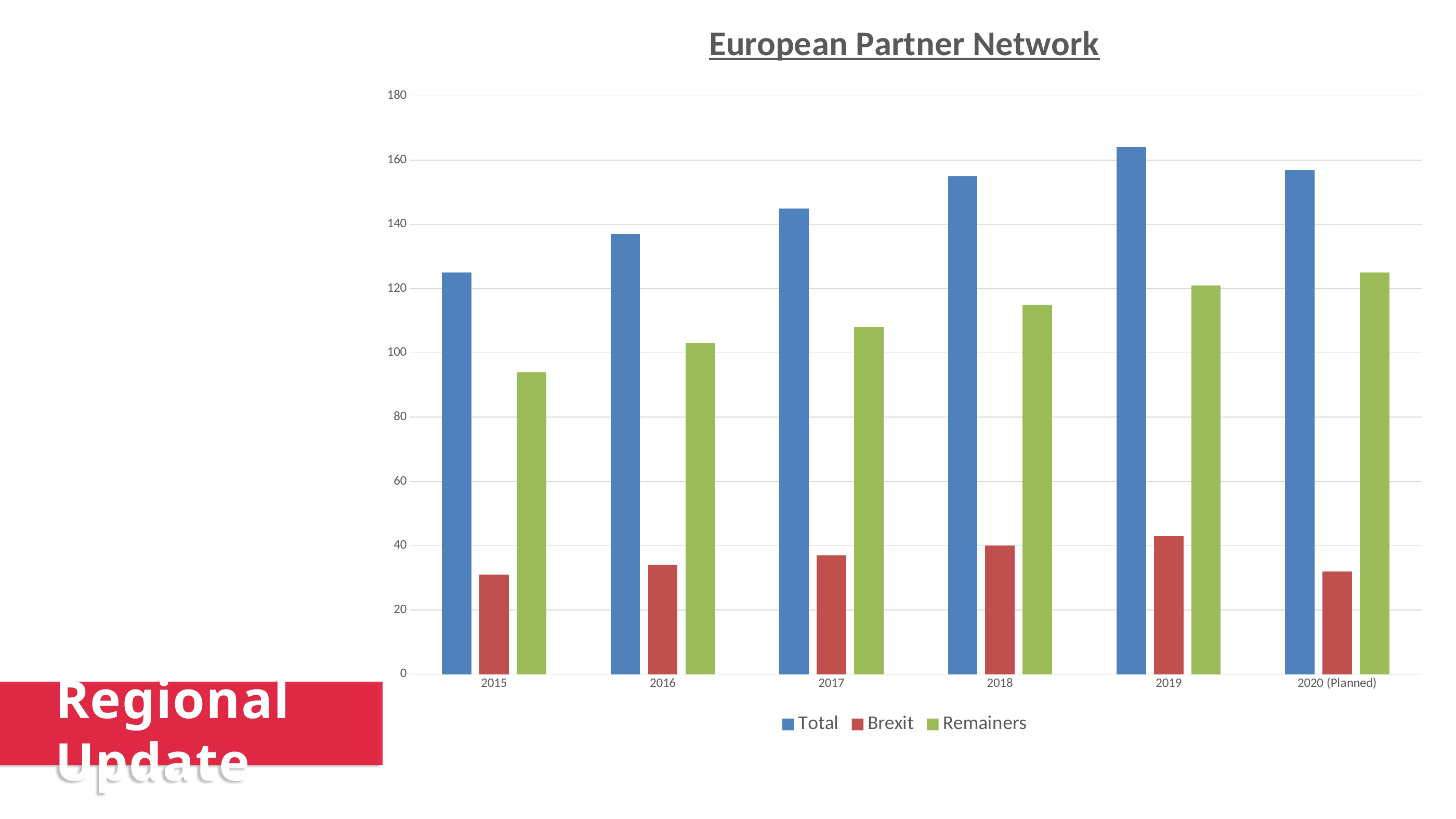
Which is larger, the Brexit value for 2018 or the Brexit value for 2016? 2018 In which year is the Total series highest? 2019 Do the Remainers values rise or fall from 2015 to 2020 (Planned)? rise What kind of chart is shown on the slide? Bar chart In which year is the Brexit series highest? 2019 Is the Brexit value for 2018 greater or less than 60? less How many year categories are shown on the x axis? 6 In which year is the Remainers series highest? 2020 (Planned) Is the Total value for 2019 greater or less than 160? greater How many series does the legend list? 3 In which year is the Total series lowest? 2015 Is the Remainers value for 2015 greater or less than 100? less